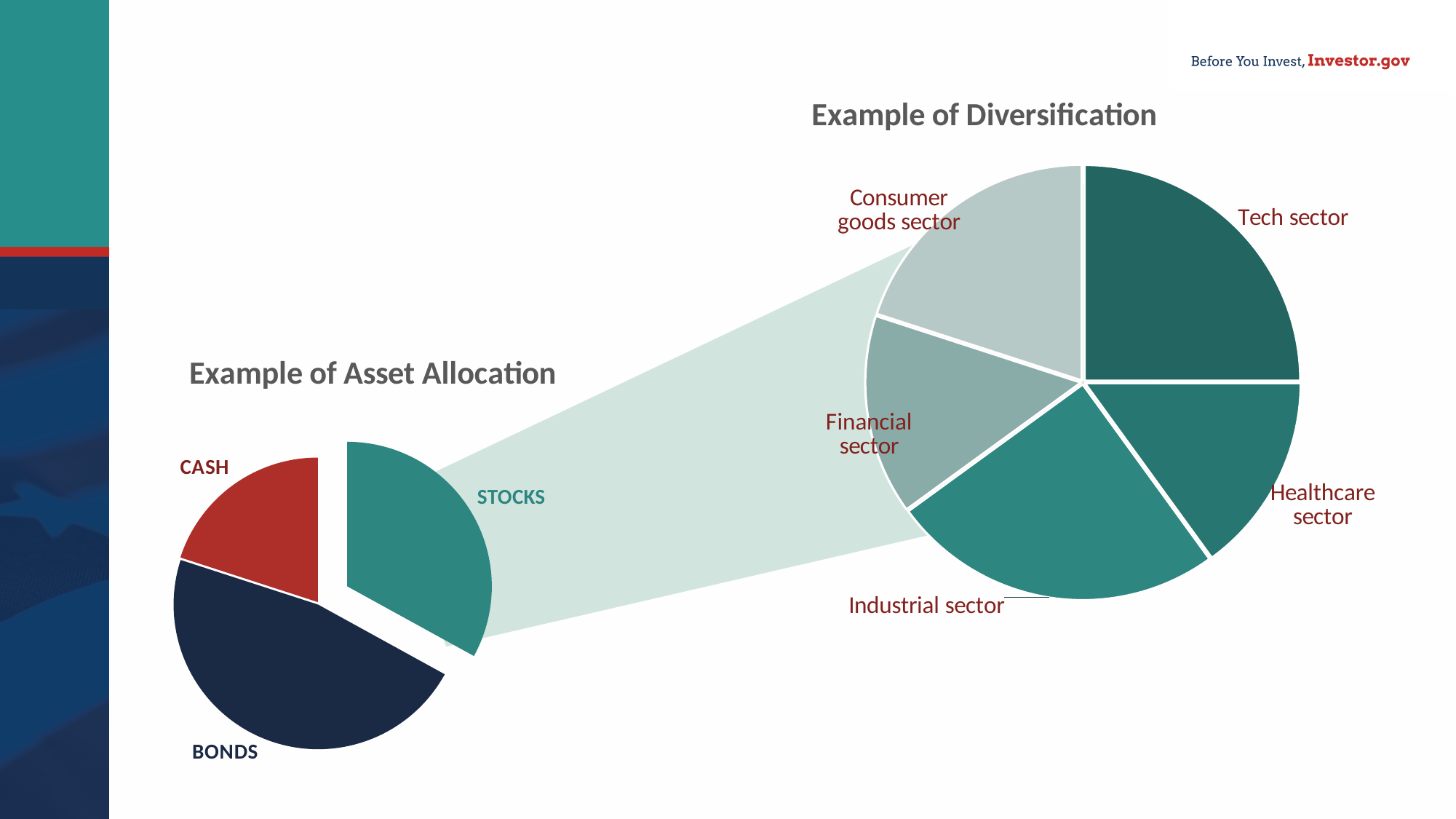
In the "Example of Asset Allocation" chart, which asset class has the largest slice? BONDS In the "Example of Diversification" chart, which slice is larger, Tech sector or Healthcare sector? Tech sector In the "Example of Asset Allocation" chart, which slice is pulled out from the rest of the pie? STOCKS Which slice of the "Example of Asset Allocation" chart is broken down in the "Example of Diversification" chart? STOCKS In the "Example of Diversification" chart, which slice is larger, Industrial sector or Financial sector? Industrial sector In the "Example of Diversification" chart, how many sectors are shown? 5 In the "Example of Asset Allocation" chart, which slice is larger, STOCKS or CASH? STOCKS What kind of chart is the "Example of Asset Allocation" chart? Pie chart What kind of chart is the "Example of Diversification" chart? Pie chart In the "Example of Asset Allocation" chart, which asset class has the smallest slice? CASH In the "Example of Asset Allocation" chart, how many slices does the pie have? 3